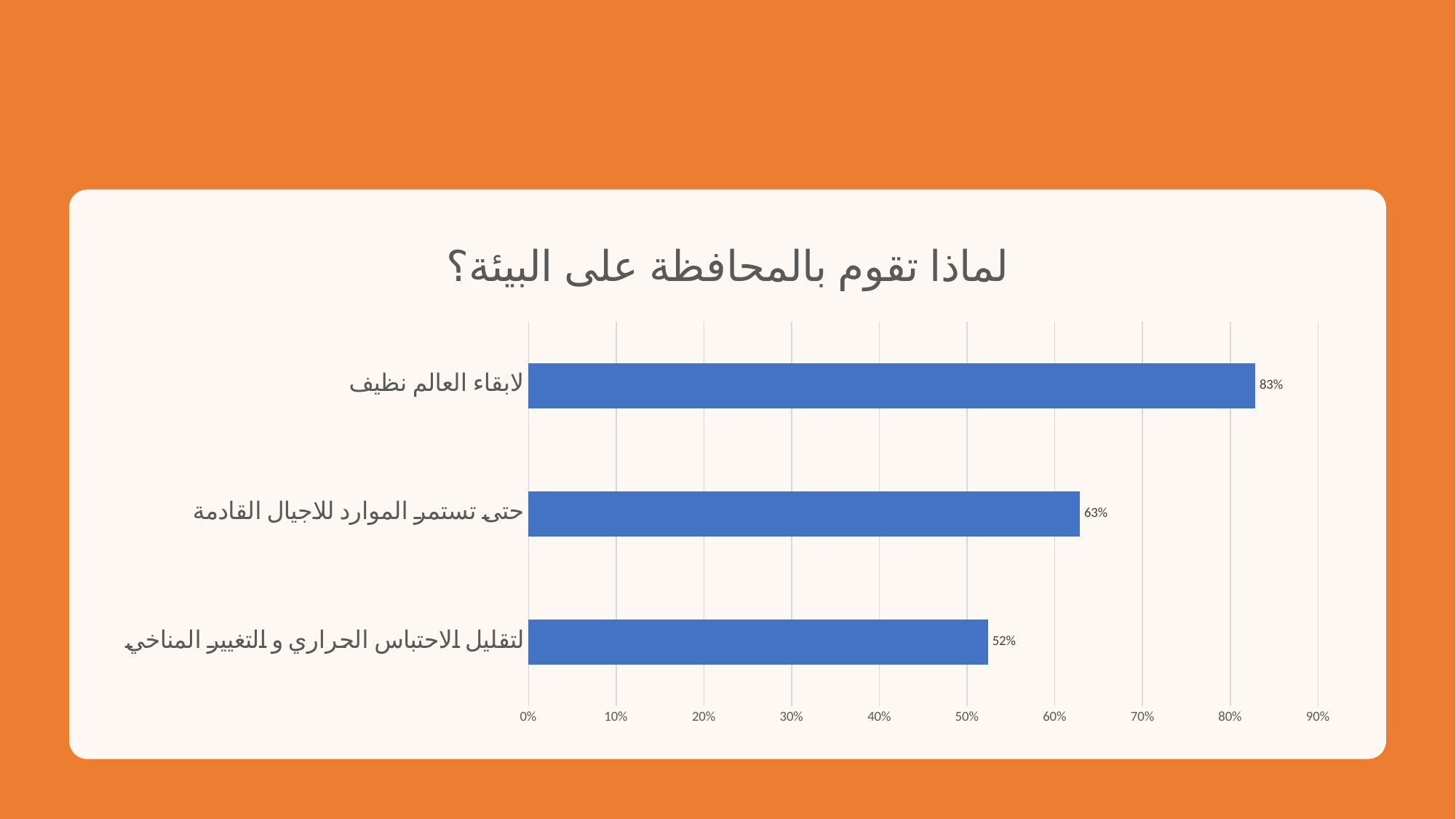
What is the value for "حتى تستمر الموارد للاجيال القادمة"? 63% Which is larger: the value for "حتى تستمر الموارد للاجيال القادمة" or the value for "لتقليل الاحتباس الحراري و التغيير المناخي"? حتى تستمر الموارد للاجيال القادمة How many categories are shown in the chart? 3 What is the value for "لابقاء العالم نظيف"? 83% What is the difference between the values for "حتى تستمر الموارد للاجيال القادمة" and "لتقليل الاحتباس الحراري و التغيير المناخي"? 11% What is the value for "لتقليل الاحتباس الحراري و التغيير المناخي"? 52% What is the difference between the values for "لابقاء العالم نظيف" and "حتى تستمر الموارد للاجيال القادمة"? 20% What is the title of the chart? لماذا تقوم بالمحافظة على البيئة؟ What kind of chart is shown on the slide? bar chart Which category has the highest value? لابقاء العالم نظيف Is the value for "لابقاء العالم نظيف" greater or less than 80%? greater Which category has the lowest value? لتقليل الاحتباس الحراري و التغيير المناخي